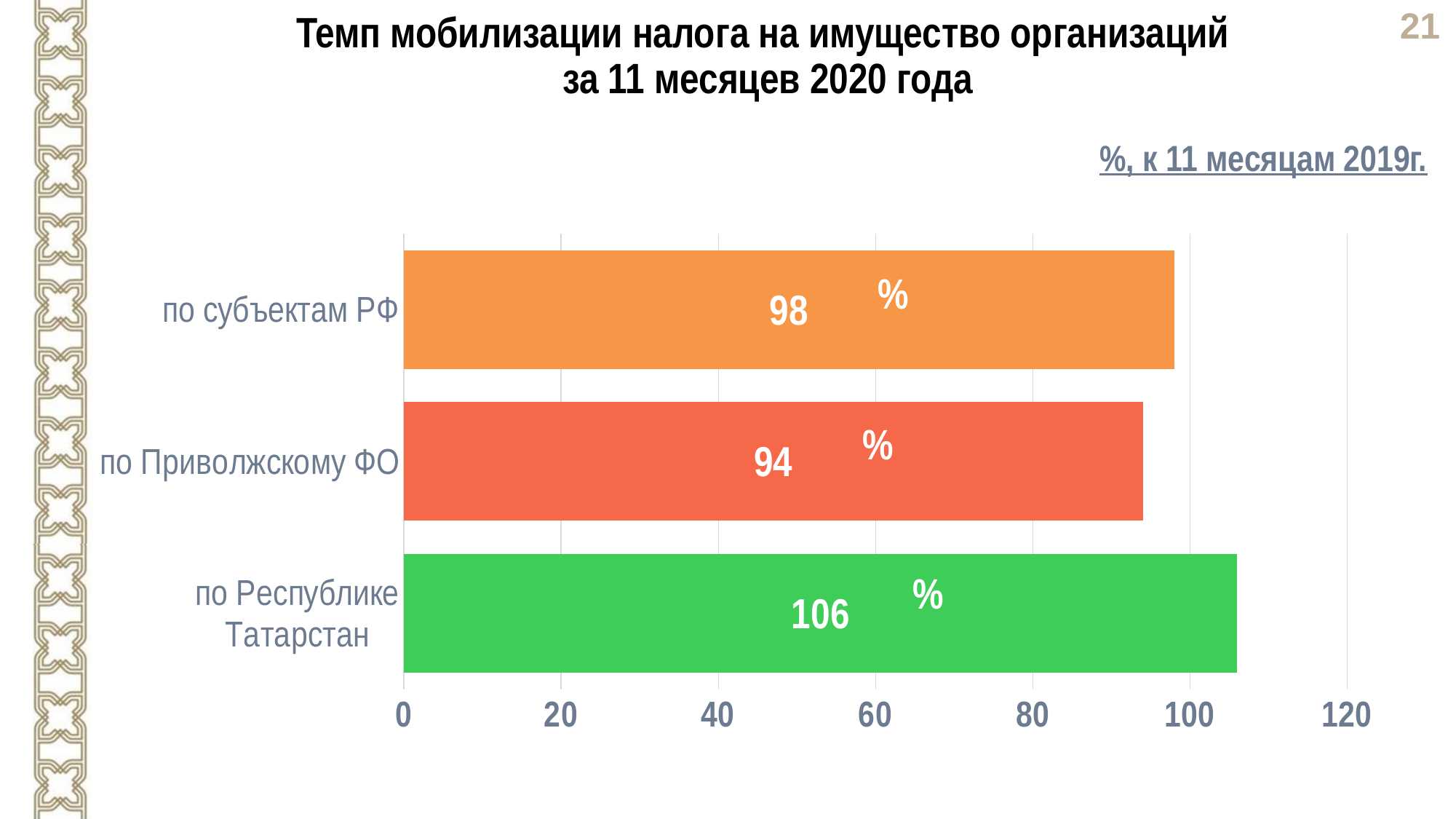
How many categories are shown in the chart? 3 What is the title of the chart? Темп мобилизации налога на имущество организаций за 11 месяцев 2020 года Is the value for по Республике Татарстан greater or less than 100? greater Which category has the highest value? по Республике Татарстан What is the value for по Республике Татарстан? 106 What is the difference between the values for по Республике Татарстан and по субъектам РФ? 8 What is the value for по Приволжскому ФО? 94 What is the difference between the values for по субъектам РФ and по Приволжскому ФО? 4 What is the value for по субъектам РФ? 98 Which category has the lowest value? по Приволжскому ФО Which is larger, the value for по Приволжскому ФО or the value for по Республике Татарстан? по Республике Татарстан What kind of chart is shown on the slide? bar chart